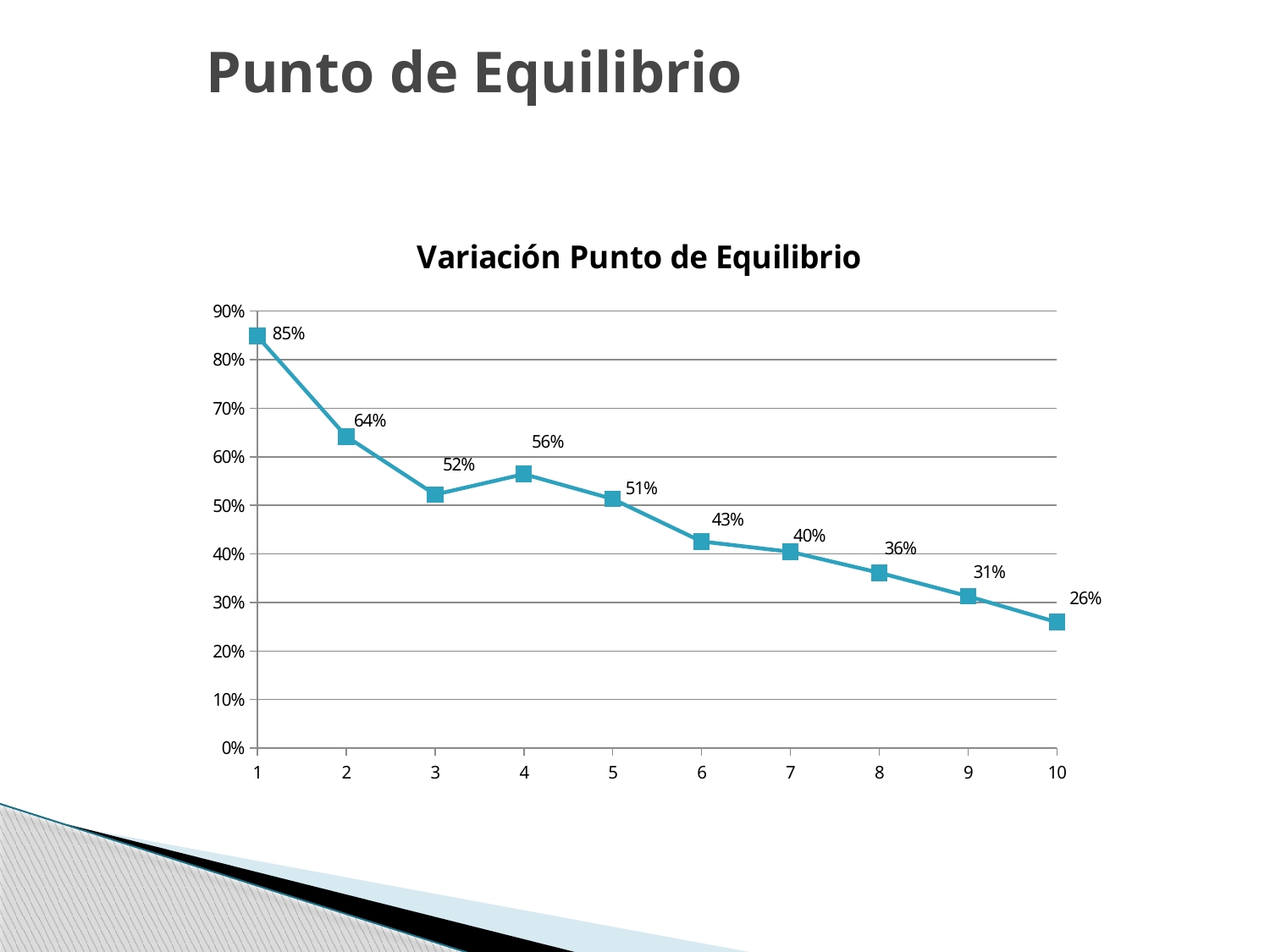
What kind of chart is shown? line chart What is the value at point 4? 56% Which point has the lowest value? 10 What is the value at point 10? 26% Do the values generally rise or fall from point 1 to point 10? fall What is the difference between the values at point 3 and point 4? 4% What is the difference between the values at point 1 and point 2? 21% What is the value at point 1? 85% Which is larger, the value at point 4 or the value at point 3? point 4 How many data points are plotted on the chart? 10 What is the title of the chart? Variación Punto de Equilibrio Which point has the highest value? 1